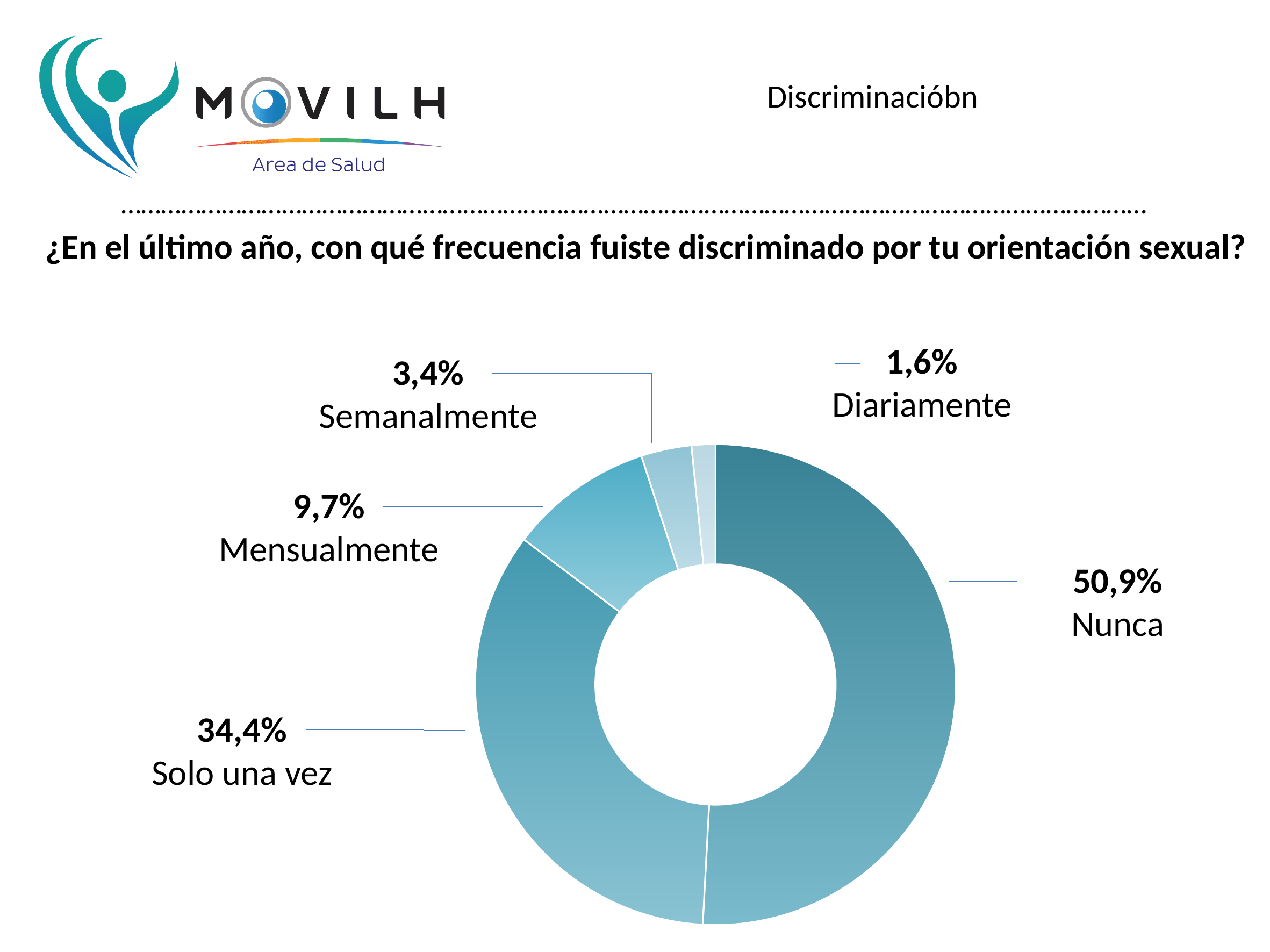
Which is larger, the share for "Mensualmente" or the share for "Semanalmente"? Mensualmente What is the difference in percentage points between "Nunca" and "Solo una vez"? 16,5 What percentage of respondents answered "Semanalmente"? 3,4% What kind of chart is shown on the slide? Doughnut chart What question does the chart answer, according to the slide heading? ¿En el último año, con qué frecuencia fuiste discriminado por tu orientación sexual? Which category has the largest share of the chart? Nunca What percentage of respondents answered "Solo una vez"? 34,4% What percentage of respondents answered "Nunca"? 50,9% How many categories are shown in the chart? 5 What percentage of respondents answered "Mensualmente"? 9,7% What percentage of respondents answered "Diariamente"? 1,6% Which category has the smallest share of the chart? Diariamente